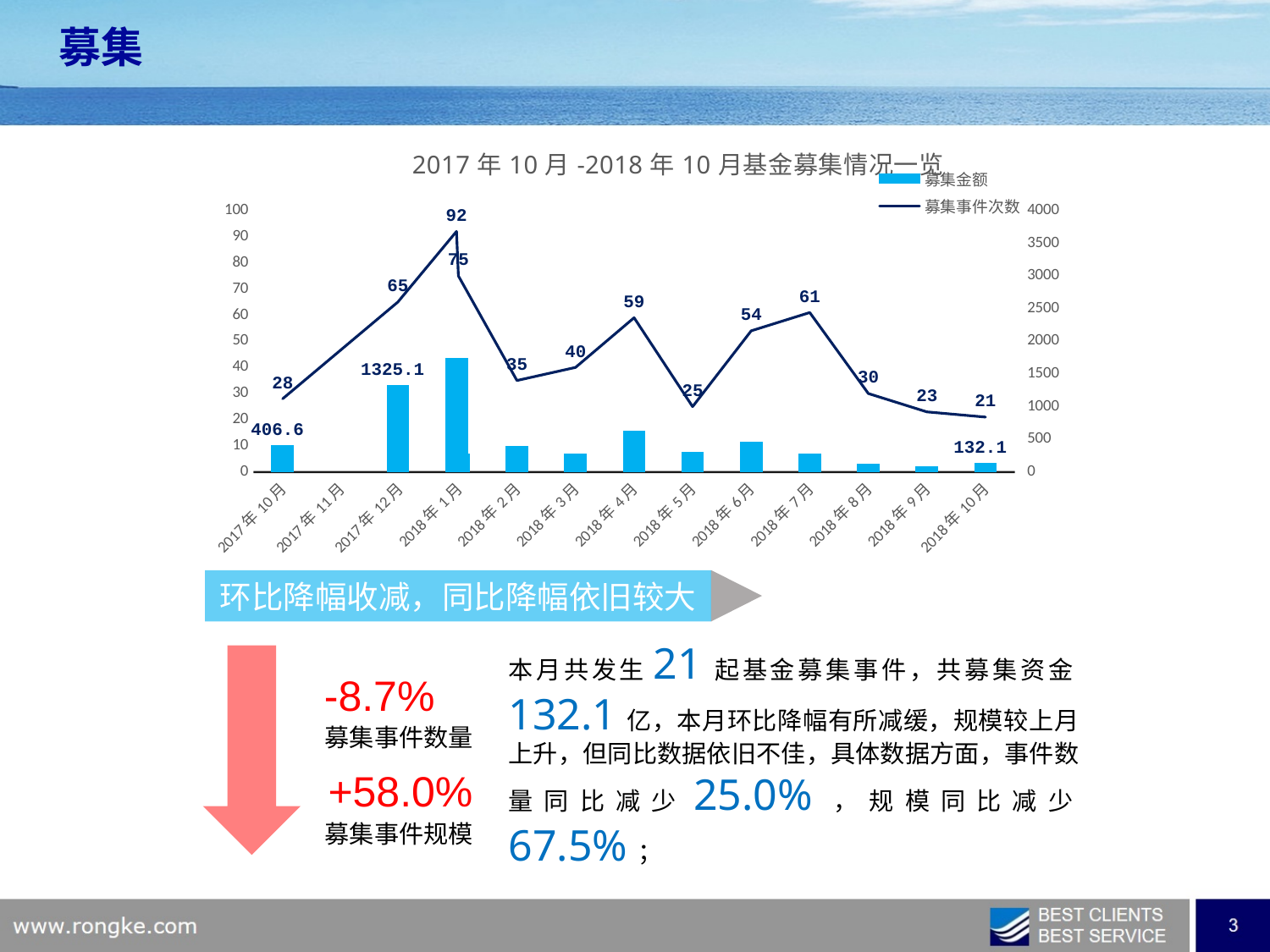
Which month has the higher 募集事件次数, 2018年5月 or 2018年6月? 2018年6月 What kind of chart is shown on the slide? A combination bar and line chart How many series does the chart legend list? 2 What is the difference in 募集事件次数 between 2018年7月 and 2018年8月? 31 What are the two legend entries of the chart? 募集金额 and 募集事件次数 How many months are shown on the x axis of the chart? 13 What is the 募集金额 value labelled for 2017年10月? 406.6 Does the 募集事件次数 line rise or fall from 2018年7月 to 2018年10月? Fall What is the 募集金额 value labelled for 2018年10月? 132.1 What is the 募集事件次数 value for 2018年10月? 21 What is the 募集事件次数 value for 2018年4月? 59 Which month has the lowest 募集事件次数 on the chart? 2018年10月